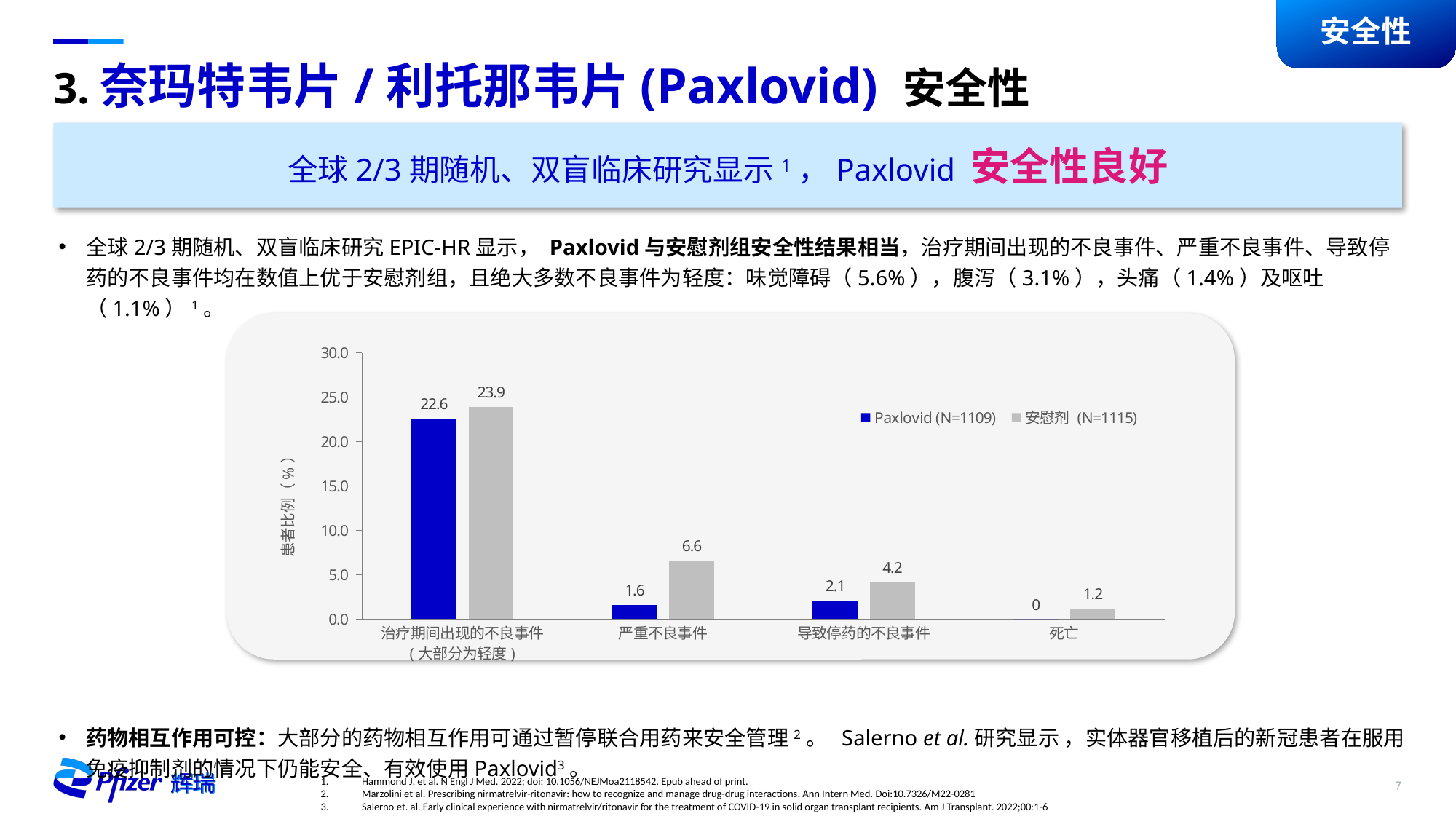
Which category has the highest value for the 安慰剂 (N=1115) series? 治疗期间出现的不良事件（大部分为轻度） Which category has the lowest value for the Paxlovid (N=1109) series? 死亡 What is the value for Paxlovid (N=1109) in the 治疗期间出现的不良事件 category? 22.6 What is the label of the y axis of the chart? 患者比例（%） How many series does the chart legend list? 2 What is the value for 安慰剂 (N=1115) in the 导致停药的不良事件 category? 4.2 What is the difference between the 安慰剂 (N=1115) and Paxlovid (N=1109) values in the 严重不良事件 category? 5.0 What type of chart is shown on the slide? bar chart What is the value for 安慰剂 (N=1115) in the 严重不良事件 category? 6.6 What is the value for Paxlovid (N=1109) in the 死亡 category? 0 In the 导致停药的不良事件 category, which series has the larger value, Paxlovid (N=1109) or 安慰剂 (N=1115)? 安慰剂 (N=1115) How many categories are shown on the x axis of the chart? 4